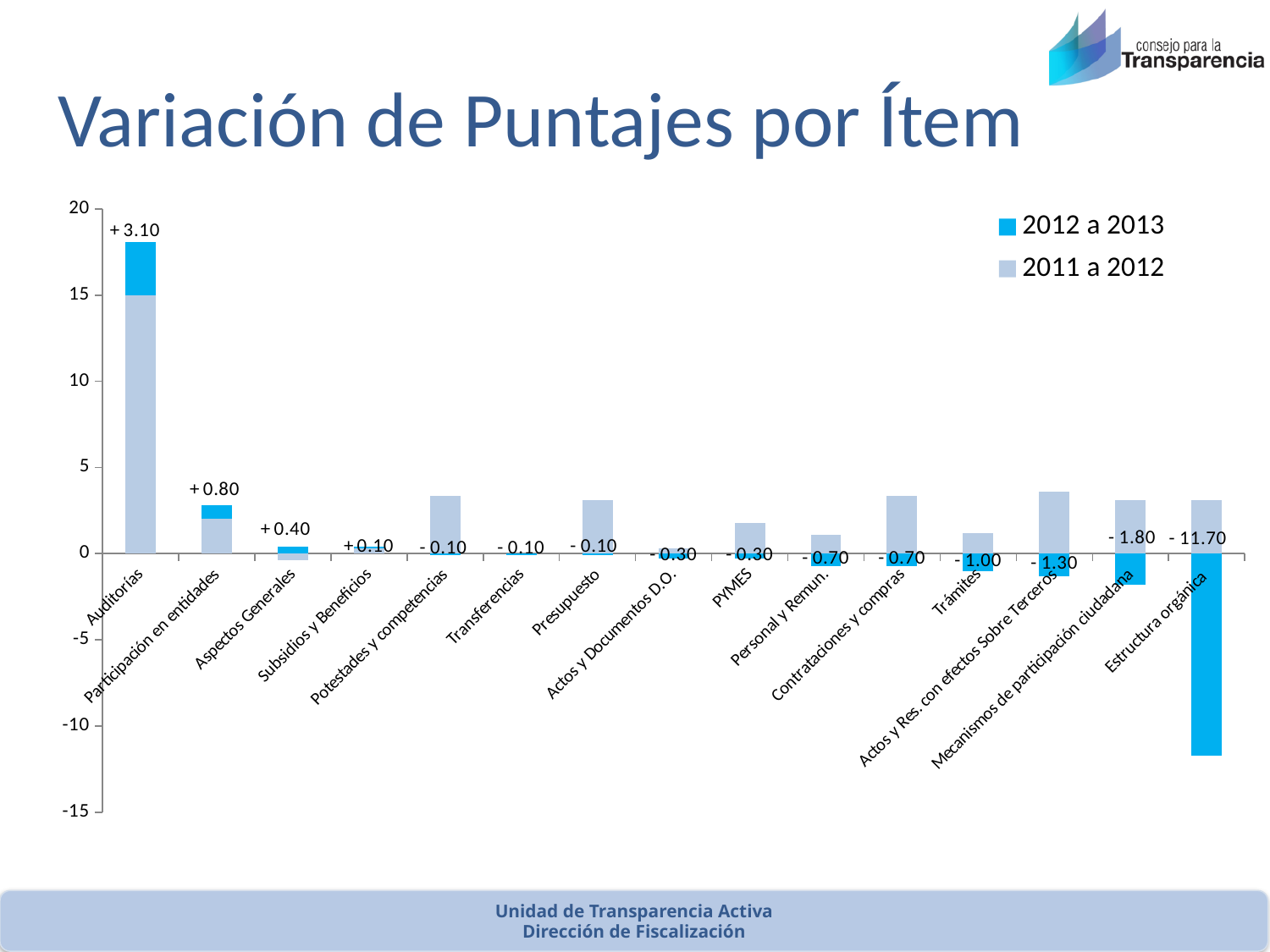
What kind of chart is shown on the slide? bar chart Which item has the highest value in the 2012 a 2013 series? Auditorías What is the value of the 2012 a 2013 series for Auditorías? + 3.10 Which item has the lowest value in the 2012 a 2013 series? Estructura orgánica What is the title of the chart on the slide? Variación de Puntajes por Ítem What is the value of the 2012 a 2013 series for Estructura orgánica? - 11.70 How many series does the legend list? 2 What is the value of the 2012 a 2013 series for Aspectos Generales? + 0.40 Is the 2011 a 2012 value for Auditorías greater or less than 10? greater What is the difference between the 2012 a 2013 values for Auditorías and Participación en entidades? 2.30 How many items are shown on the x axis of the chart? 15 In the 2012 a 2013 series, which is larger: the value for Trámites or the value for Mecanismos de participación ciudadana? Trámites